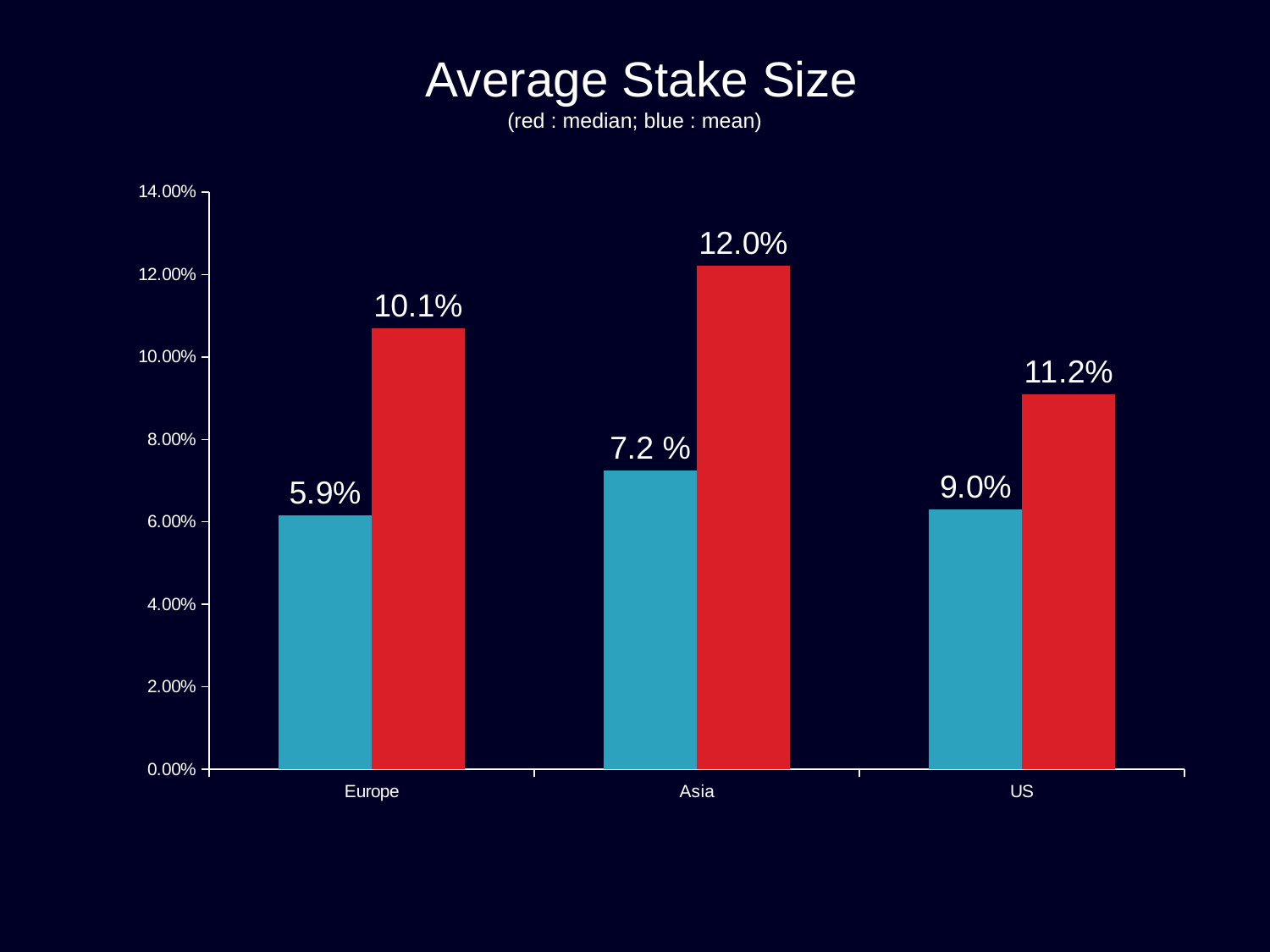
Which colour represents the median in the chart? red What is the difference between the median average stake size for Asia and for Europe? 1.9 percentage points Which region has the highest median average stake size? Asia What is the median average stake size for US? 11.2% What is the median average stake size for Asia? 12.0% What is the mean average stake size for Europe? 5.9% How many series does the chart show? 2 What is the mean average stake size for Asia? 7.2 % For Europe, which is larger: the median or the mean average stake size? median How many regions are shown on the x axis? 3 Which region has the lowest mean average stake size? Europe What kind of chart is shown on the slide? bar chart